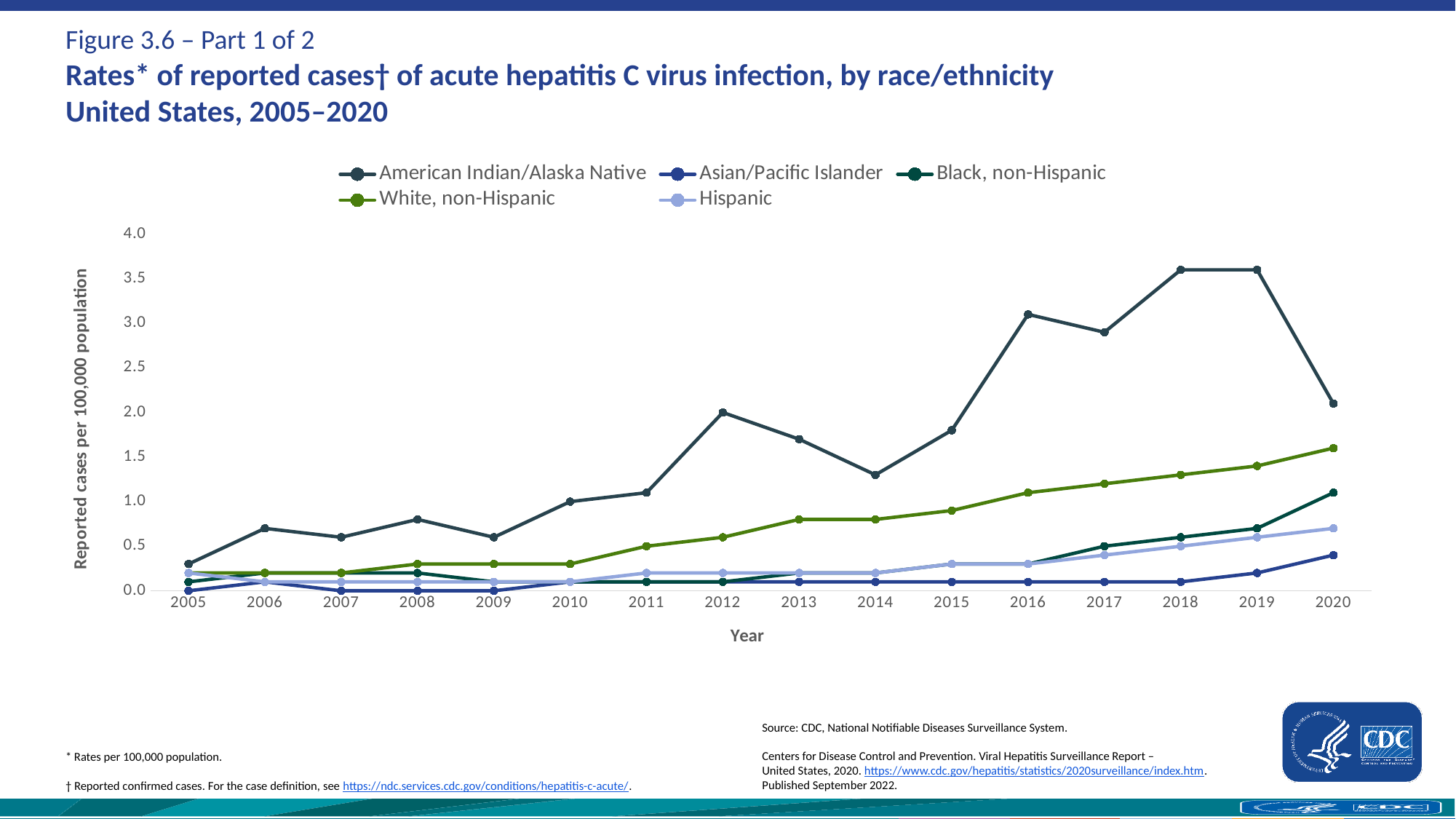
Which race/ethnicity group has the lowest rate in 2020? Asian/Pacific Islander Is the value for American Indian/Alaska Native in 2012 greater or less than 1.5? greater Is the value for American Indian/Alaska Native in 2018 greater or less than 3.0? greater How many years are plotted along the x axis? 16 In 2016, which is higher: the rate for American Indian/Alaska Native or the rate for White, non-Hispanic? American Indian/Alaska Native What is the label of the y axis? Reported cases per 100,000 population Is the value for White, non-Hispanic in 2020 greater or less than 1.0? greater In 2020, which is higher: the rate for Black, non-Hispanic or the rate for Hispanic? Black, non-Hispanic What kind of chart is shown on the slide? line chart Does the rate for White, non-Hispanic rise or fall from 2010 to 2020? rise Which race/ethnicity group has the highest rate in 2018? American Indian/Alaska Native How many series does the legend list? 5